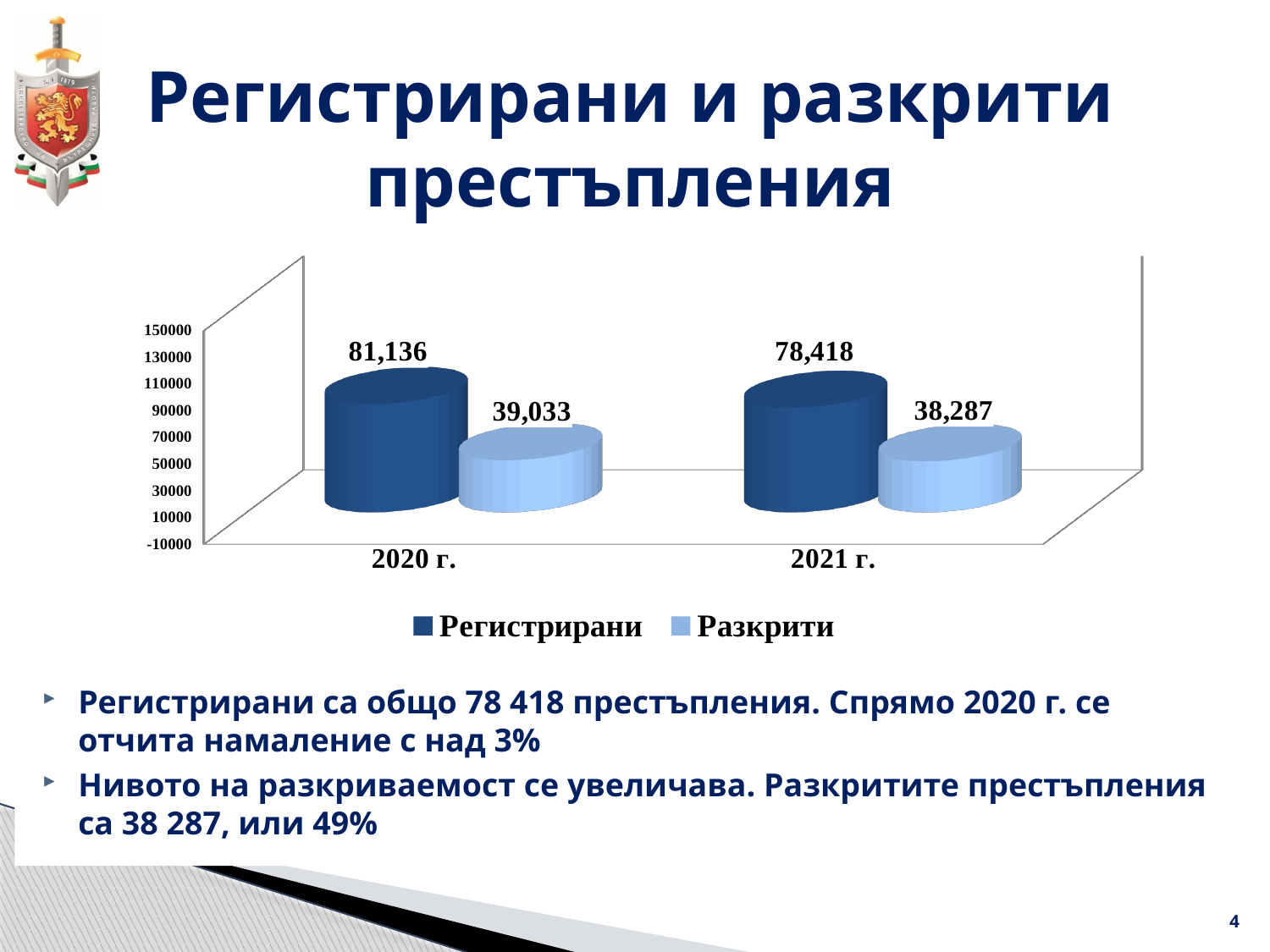
What is the value for Разкрити in 2020 г.? 39,033 What is the difference between Регистрирани in 2020 г. and Регистрирани in 2021 г.? 2,718 Does the value for Регистрирани rise or fall from 2020 г. to 2021 г.? fall How many series does the legend list? 2 Which is larger in 2020 г., Регистрирани or Разкрити? Регистрирани How many categories are shown on the x axis? 2 What is the value for Регистрирани in 2020 г.? 81,136 Which year has the lower value for Разкрити? 2021 г. What is the difference between Регистрирани and Разкрити in 2021 г.? 40,131 What is the value for Разкрити in 2021 г.? 38,287 What is the value for Регистрирани in 2021 г.? 78,418 Which year has the higher value for Регистрирани? 2020 г.